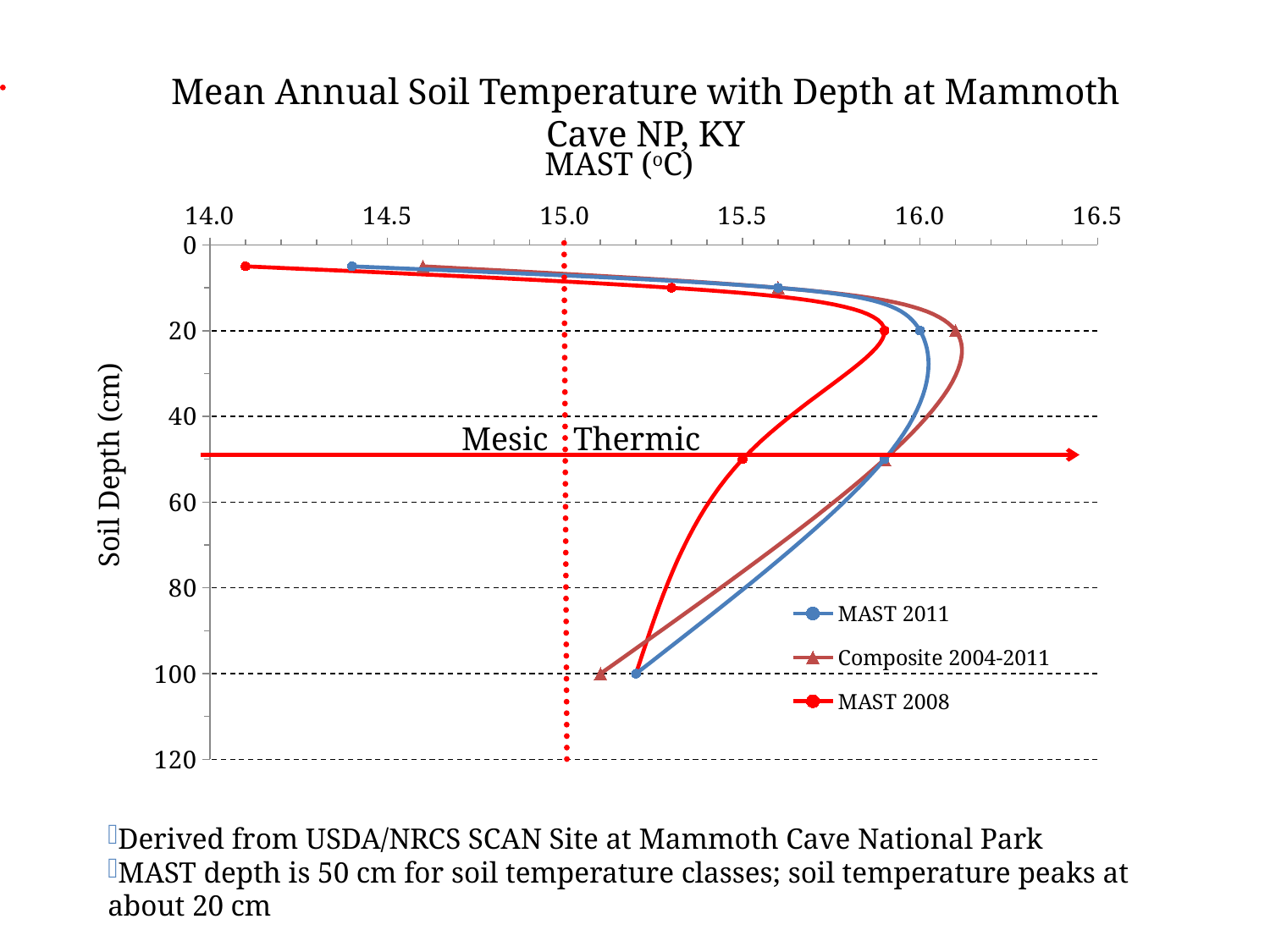
What kind of chart is shown on the slide? line chart Is the Composite 2004-2011 value at 100 cm soil depth greater or less than 15.5? less At which soil depth does the MAST 2008 series reach its highest temperature? 20 cm Is the MAST 2008 value at 5 cm soil depth greater or less than 14.5? less At 50 cm soil depth, which series has the higher temperature, MAST 2011 or MAST 2008? MAST 2011 How many series does the legend list? 3 Is the MAST 2008 value at 50 cm soil depth greater or less than 16.0? less How many data points are plotted for the MAST 2008 series? 4 What are the three series named in the legend? MAST 2011, Composite 2004-2011, MAST 2008 Which series has the lowest temperature at 5 cm soil depth? MAST 2008 What is the title of the horizontal axis? MAST (°C)